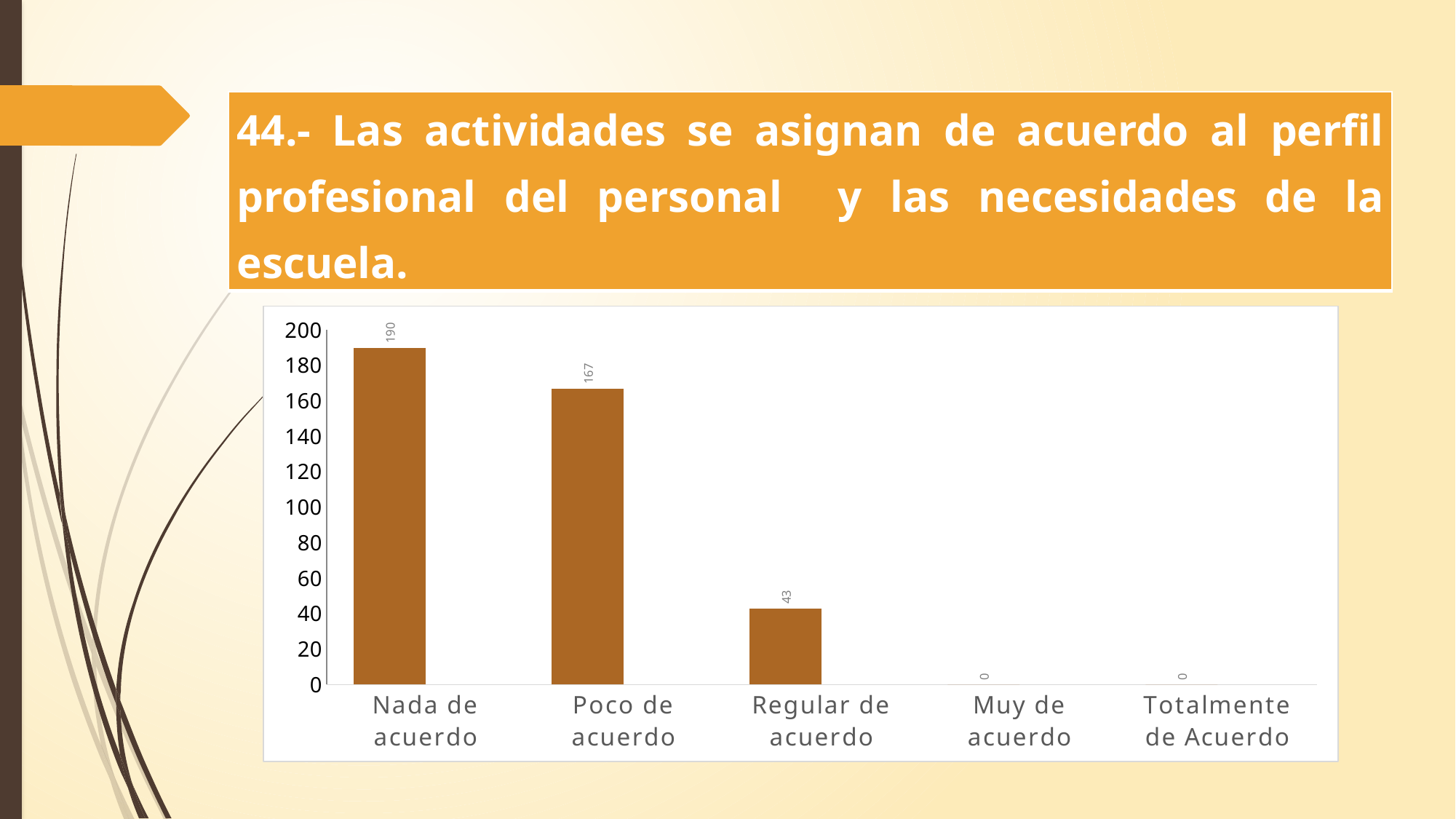
Is the value for "Regular de acuerdo" greater or less than 60? less What is the value for "Poco de acuerdo"? 167 How many categories are shown on the x axis? 5 What is the value for "Regular de acuerdo"? 43 Do the values rise or fall from left to right along the x axis? Fall What is the difference between the values for "Nada de acuerdo" and "Poco de acuerdo"? 23 Which is larger, the value for "Poco de acuerdo" or the value for "Regular de acuerdo"? Poco de acuerdo Which category has the highest value? Nada de acuerdo What is the difference between the values for "Poco de acuerdo" and "Regular de acuerdo"? 124 What kind of chart is shown on the slide? Bar chart What is the value for "Nada de acuerdo"? 190 What is the value for "Muy de acuerdo"? 0